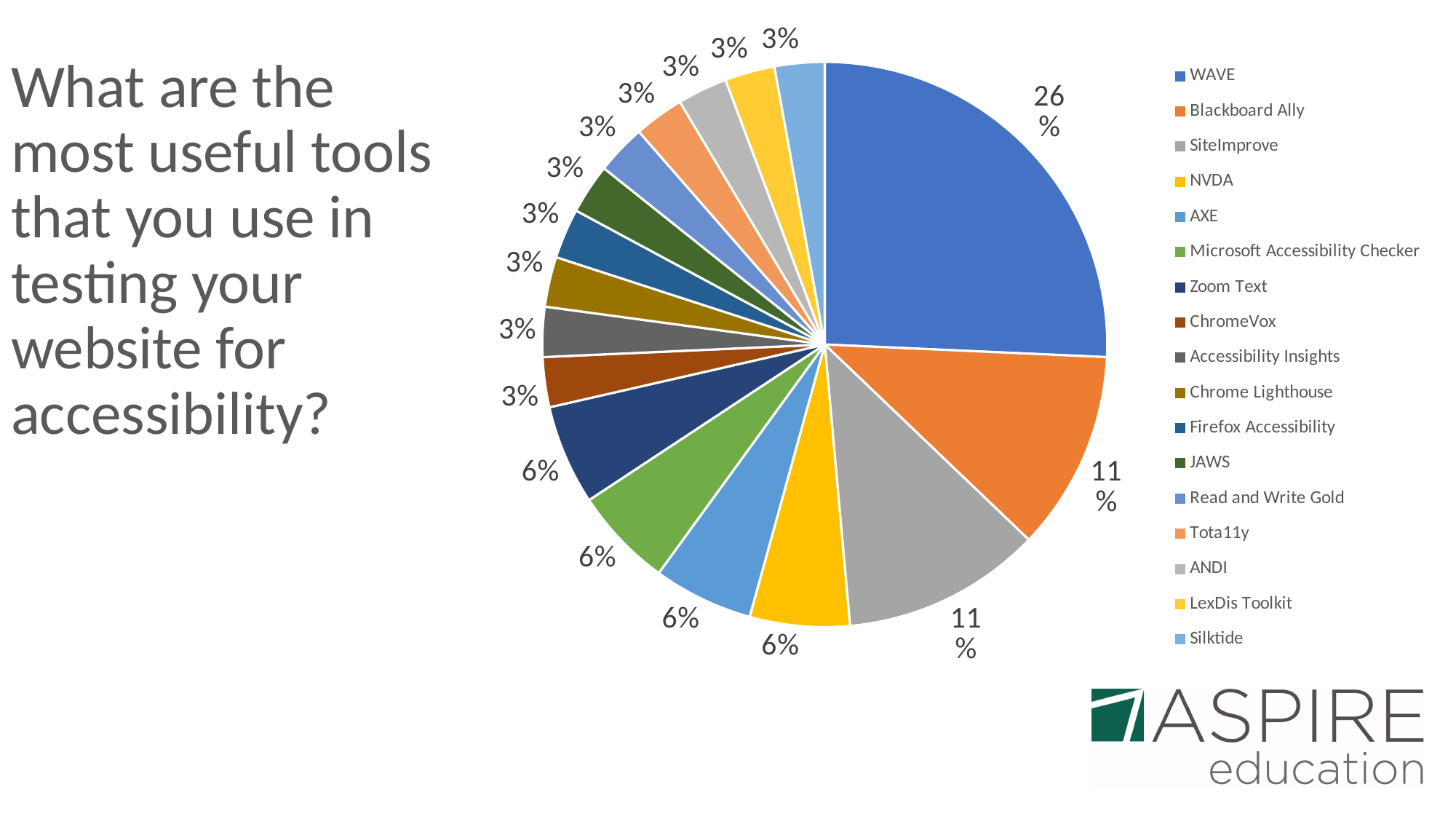
What is the value shown for SiteImprove? 11% What kind of chart is shown on the slide? Pie chart What is the value shown for JAWS? 3% What is the value shown for NVDA? 6% What question does the slide's title ask? What are the most useful tools that you use in testing your website for accessibility? What is the difference between the Zoom Text slice and the Silktide slice? 3% Which tool has the largest slice of the pie? WAVE What is the value shown for Blackboard Ally? 11% What share of the pie does WAVE account for? 26% What is the difference between the WAVE slice and the Blackboard Ally slice? 15% How many slices does the pie chart have? 17 Which is larger, the slice for Microsoft Accessibility Checker or the slice for ChromeVox? Microsoft Accessibility Checker